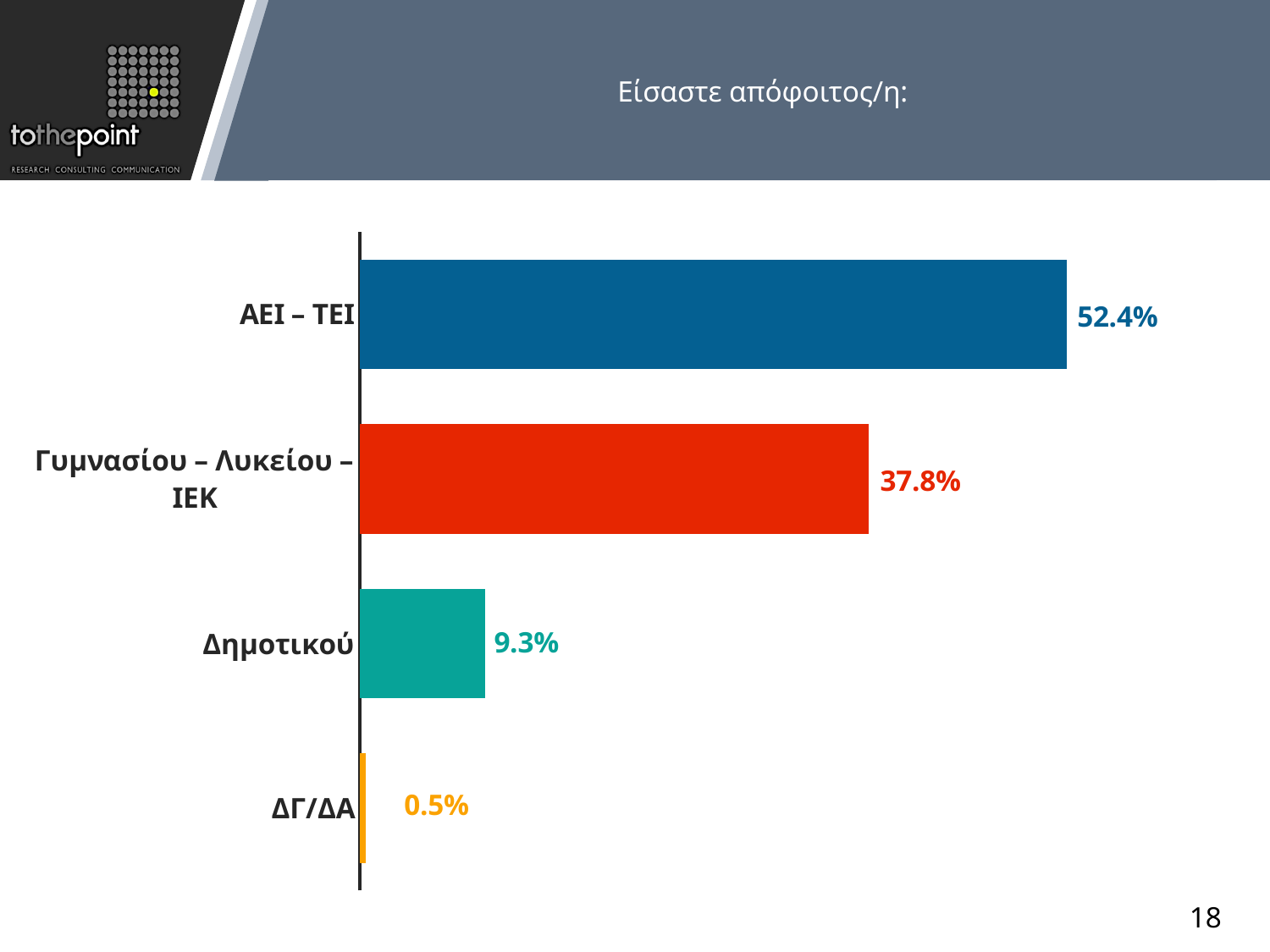
Which is larger, the value for Γυμνασίου – Λυκείου – ΙΕΚ or the value for Δημοτικού? Γυμνασίου – Λυκείου – ΙΕΚ What is the difference between the values for ΑΕΙ – ΤΕΙ and Γυμνασίου – Λυκείου – ΙΕΚ? 14.6% What is the value for Δημοτικού? 9.3% What is the value for ΔΓ/ΔΑ? 0.5% What is the value for Γυμνασίου – Λυκείου – ΙΕΚ? 37.8% What is the title of the chart? Είσαστε απόφοιτος/η: What kind of chart is shown on the slide? Bar chart What is the value for ΑΕΙ – ΤΕΙ? 52.4% How many categories are shown in the chart? 4 Which category has the lowest value? ΔΓ/ΔΑ Which category has the highest value? ΑΕΙ – ΤΕΙ What is the difference between the values for Δημοτικού and ΔΓ/ΔΑ? 8.8%